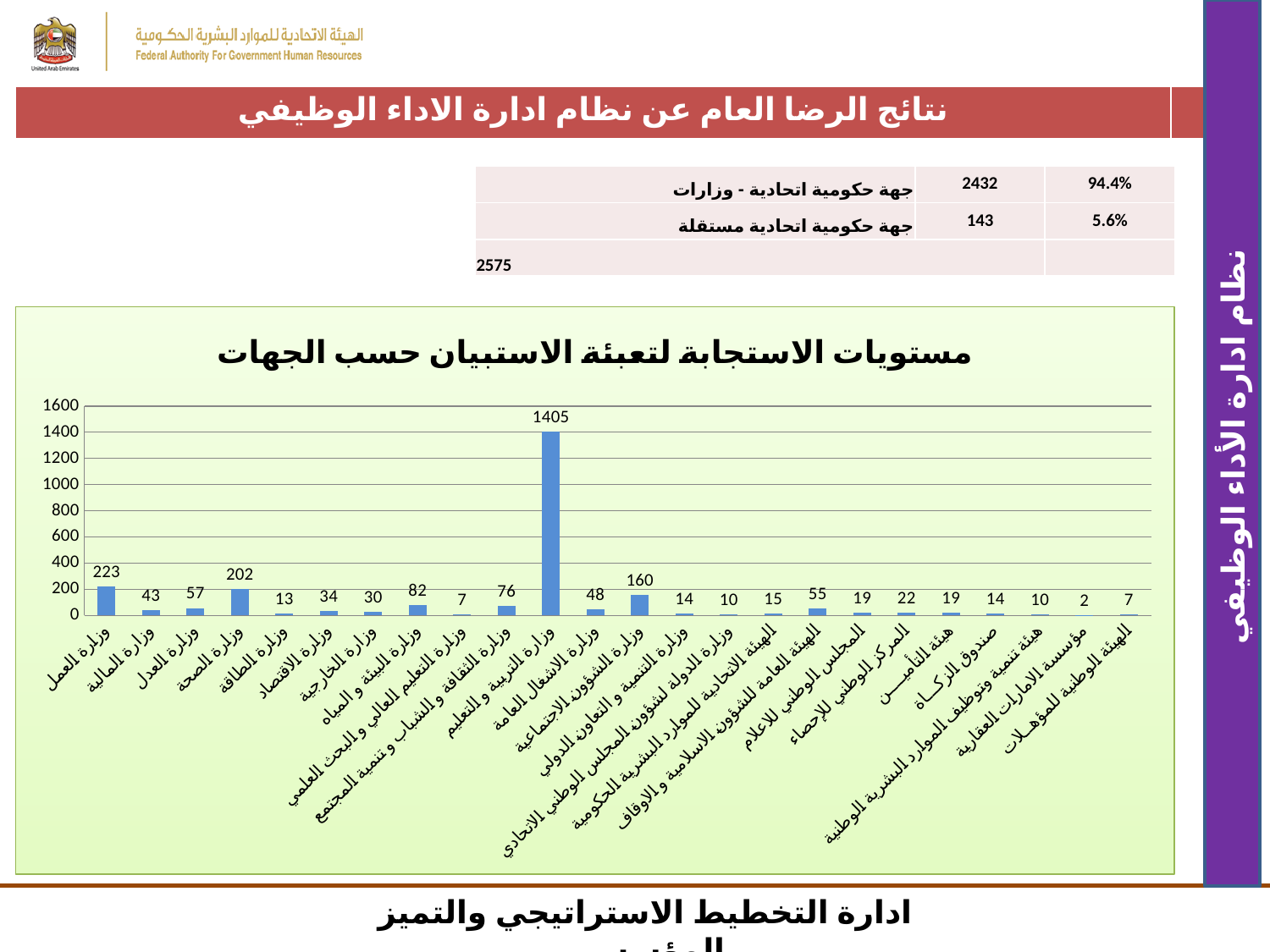
What is the title of the chart? مستويات الاستجابة لتعبئة الاستبيان حسب الجهات Is the value for وزارة التربية و التعليم greater or less than 1200? greater Which category has the lowest value? مؤسسة الامارات العقارية What is the value for وزارة الشؤون الاجتماعية? 160 What is the value for وزارة الصحة? 202 What type of chart is shown on the slide? bar chart What is the value for وزارة البيئة و المياه? 82 What is the difference between the values for وزارة العمل and وزارة الصحة? 21 How many categories are shown on the x axis? 24 Which is larger, the value for وزارة المالية or the value for وزارة العدل? وزارة العدل What is the value for وزارة العمل? 223 Which category has the highest value? وزارة التربية و التعليم